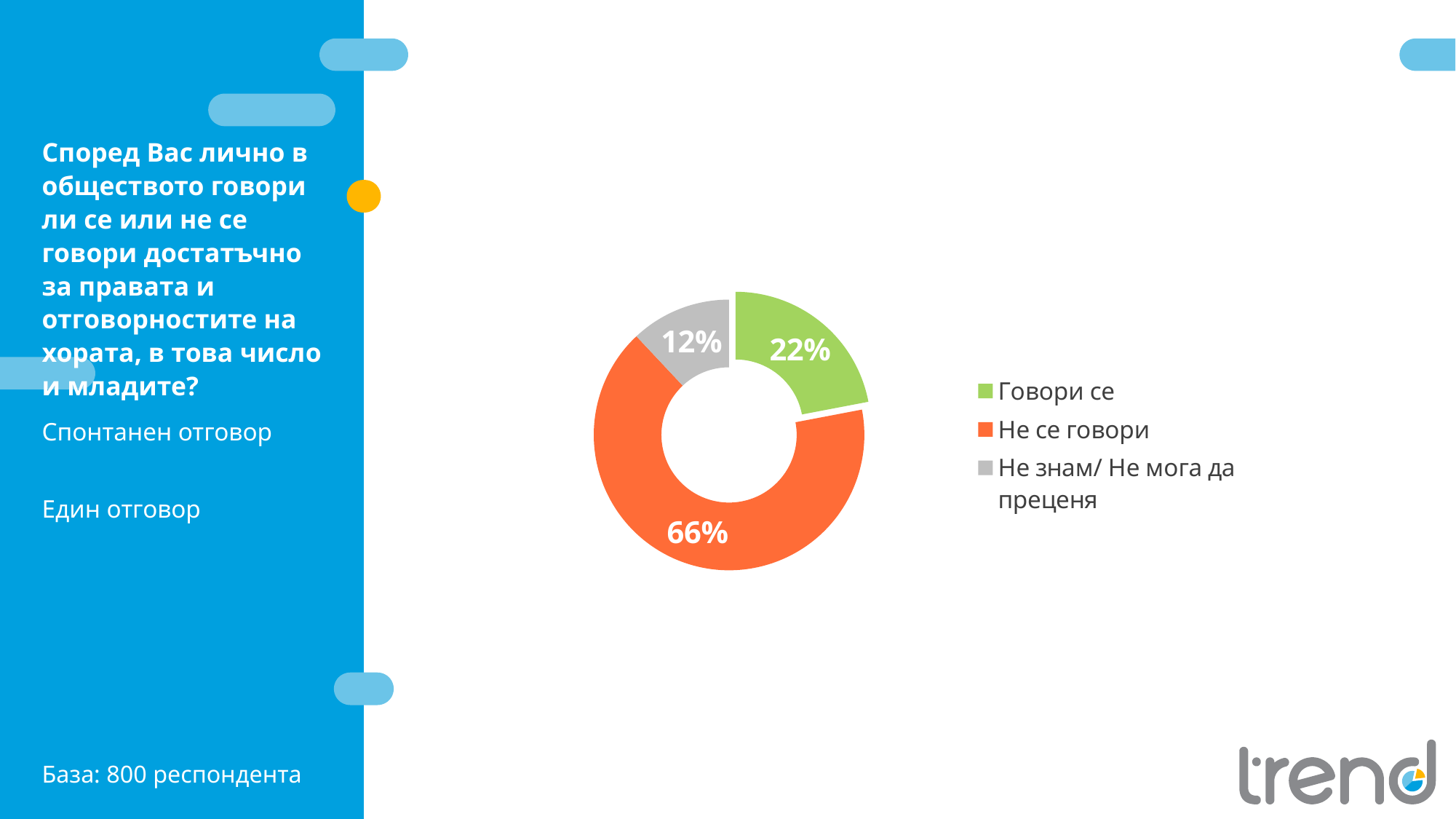
What share of respondents answered "Не знам/ Не мога да преценя"? 12% Which answer has the largest share? Не се говори What share of respondents answered "Говори се"? 22% What is the difference in percentage points between "Не се говори" and "Говори се"? 44 percentage points What colour is the slice for "Не се говори"? Orange How many categories does the chart show? 3 What share of respondents answered "Не се говори"? 66% What kind of chart is shown on the slide? Doughnut (pie) chart Which answer has the smallest share? Не знам/ Не мога да преценя How many respondents form the base of the survey shown on the slide? 800 Which is larger: the share for "Говори се" or for "Не знам/ Не мога да преценя"? Говори се How many entries does the legend list? 3